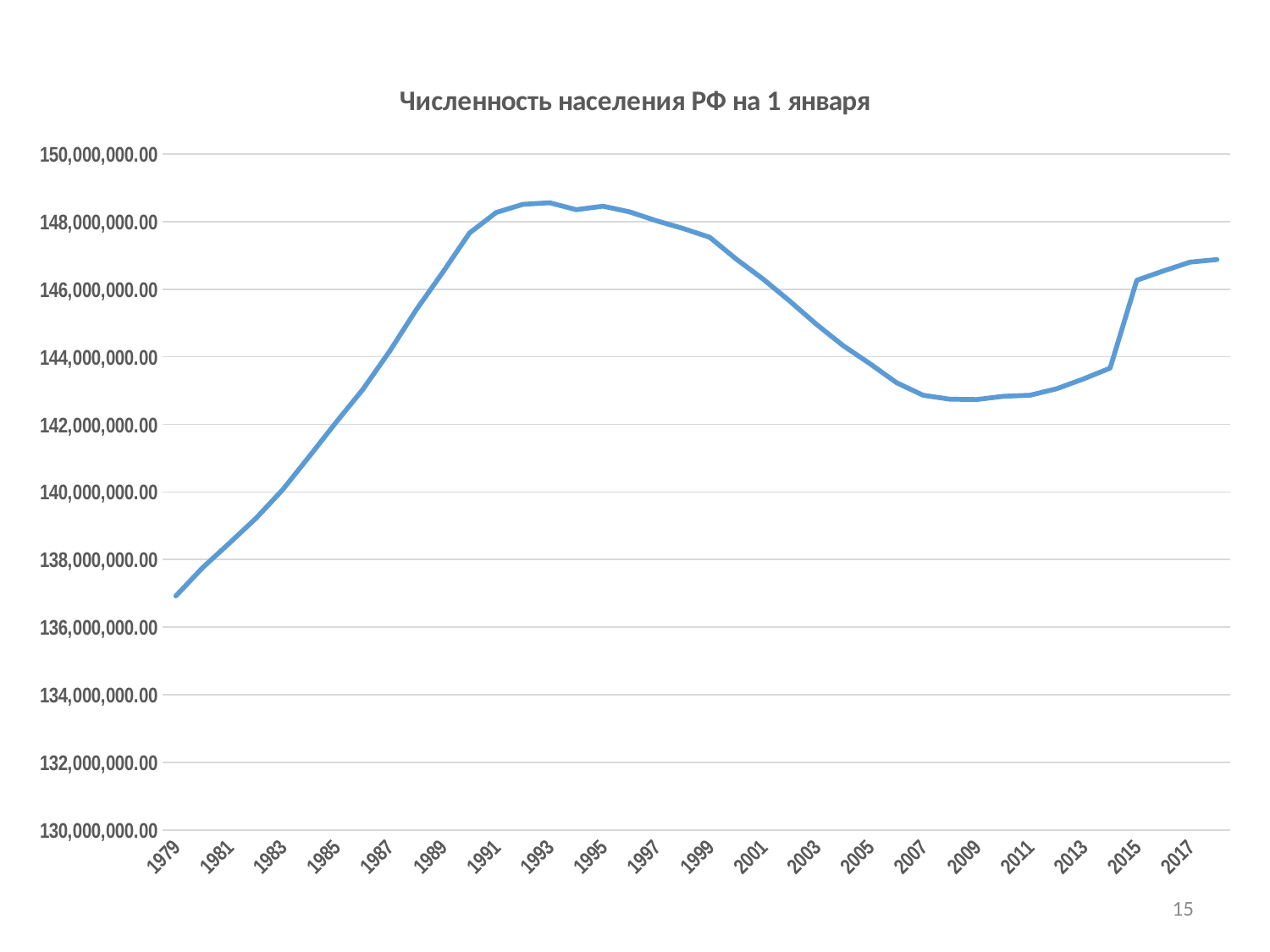
Which is larger, the value for 1993 or the value for 2009? 1993 What kind of chart is shown on the slide? line chart Is the value for 1979 greater or less than 138,000,000.00? less Is the value for 1993 greater or less than 148,000,000.00? greater Does the value rise or fall from 1999 to 2007? fall Does the value rise or fall from 1979 to 1991? rise Is the value for 2009 greater or less than 144,000,000.00? less What is the title of the chart? Численность населения РФ на 1 января In which year is the plotted value lowest? 1979